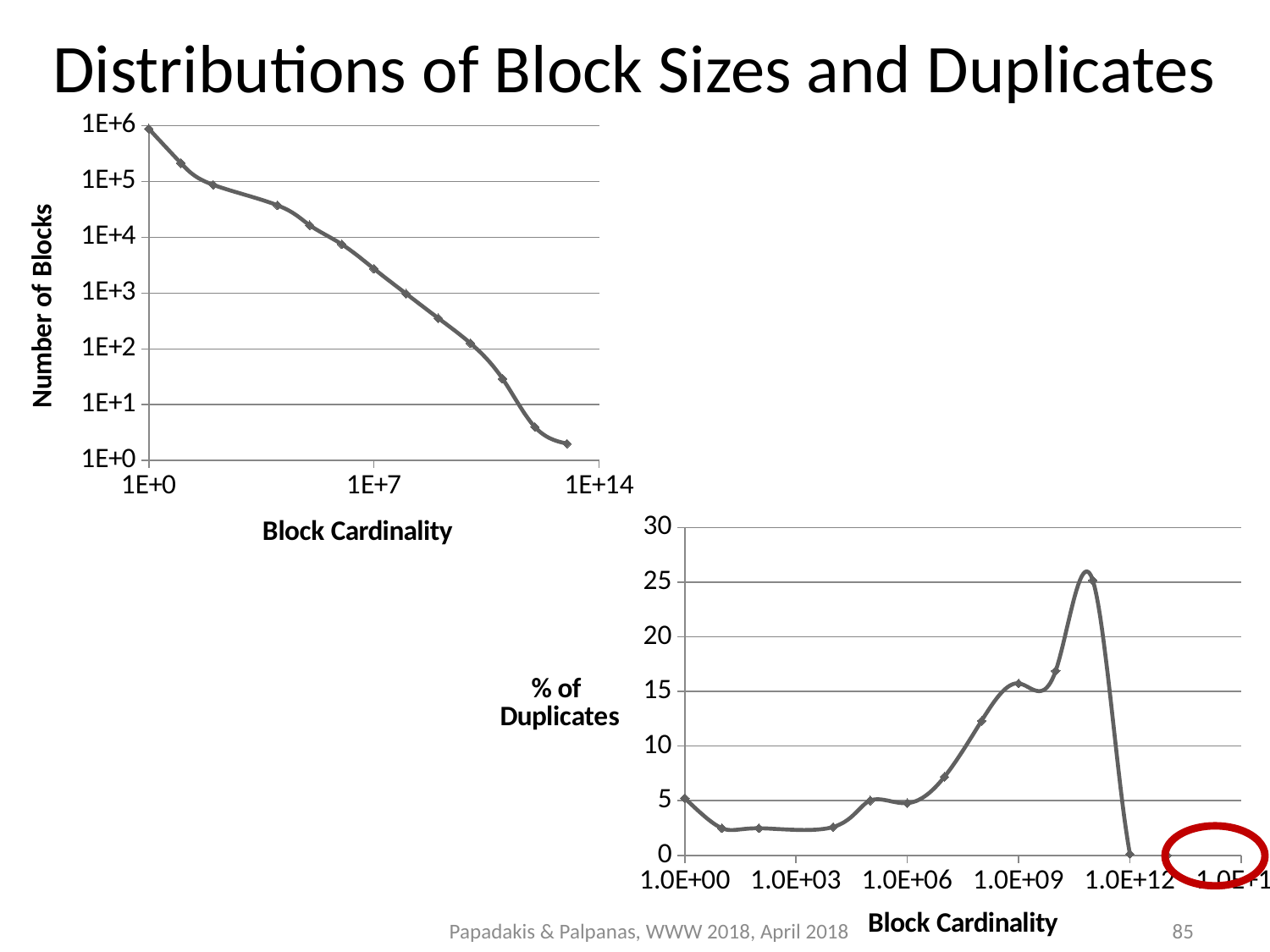
What is the label of the horizontal axis shared by both charts? Block Cardinality What is the label of the vertical axis of the top-left chart? Number of Blocks What type of chart is the top-left chart showing Number of Blocks against Block Cardinality? line chart In the top-left chart (Number of Blocks), does the number of blocks rise or fall as block cardinality increases? fall In the bottom-right chart (% of Duplicates), is the value at block cardinality 1.0E+09 greater or less than 10? greater What type of chart is the bottom-right chart showing % of Duplicates against Block Cardinality? line chart In the bottom-right chart (% of Duplicates), is the value at block cardinality 1.0E+00 greater or less than 10? less In the top-left chart (Number of Blocks), is the value at block cardinality 1E+7 greater or less than 1E+4? less In the bottom-right chart (% of Duplicates), is the value at block cardinality 1.0E+00 larger or smaller than the value at 1.0E+09? smaller